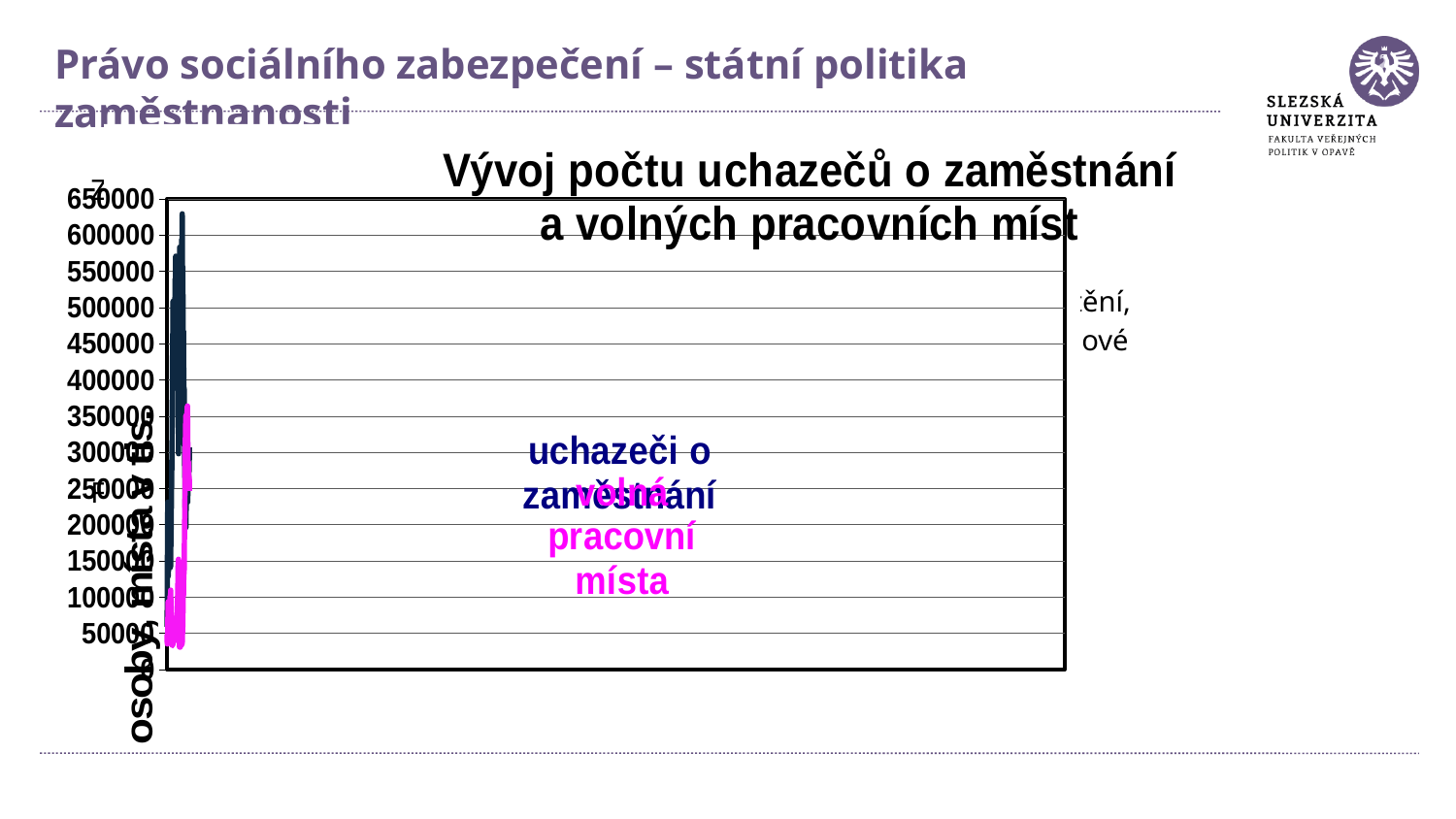
What kind of chart is shown on the slide? line chart Which series is drawn in magenta? volná pracovní místa Is the highest value of the volná pracovní místa series greater or less than 400000? less How many data series does the chart show? 2 Is the highest value of the uchazeči o zaměstnání series greater or less than 500000? greater Which series reaches higher values, uchazeči o zaměstnání or volná pracovní místa? uchazeči o zaměstnání What is the highest value shown on the vertical axis? 650000 What is the title of the chart on the slide? Vývoj počtu uchazečů o zaměstnání a volných pracovních míst